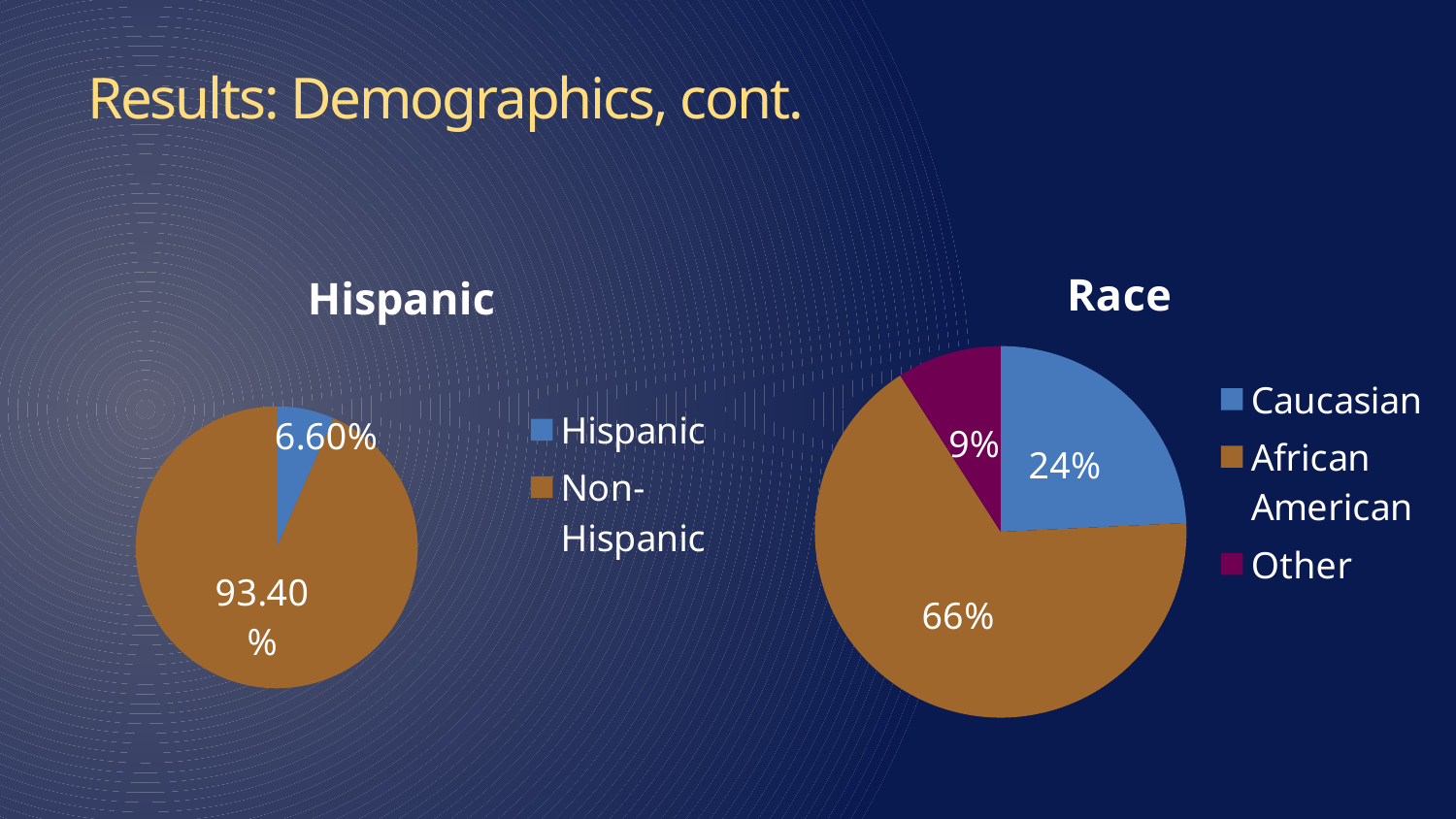
In the Race chart, what percentage is labelled for Caucasian? 24% In the Race chart, which category has the largest slice? African American In the Hispanic chart, what percentage is labelled for the Non-Hispanic slice? 93.40% In the Hispanic chart, what percentage is labelled for the Hispanic slice? 6.60% In the Race chart, what is the difference between the African American and Caucasian percentages? 42% In the Race chart, what colour is the Other slice? Purple In the Race chart, what percentage is labelled for Other? 9% What type of chart is the Hispanic chart? Pie chart In the Hispanic chart, which slice is larger, Hispanic or Non-Hispanic? Non-Hispanic In the Race chart, what percentage is labelled for African American? 66% How many categories does the legend of the Race chart list? 3 In the Race chart, which category has the smallest slice? Other